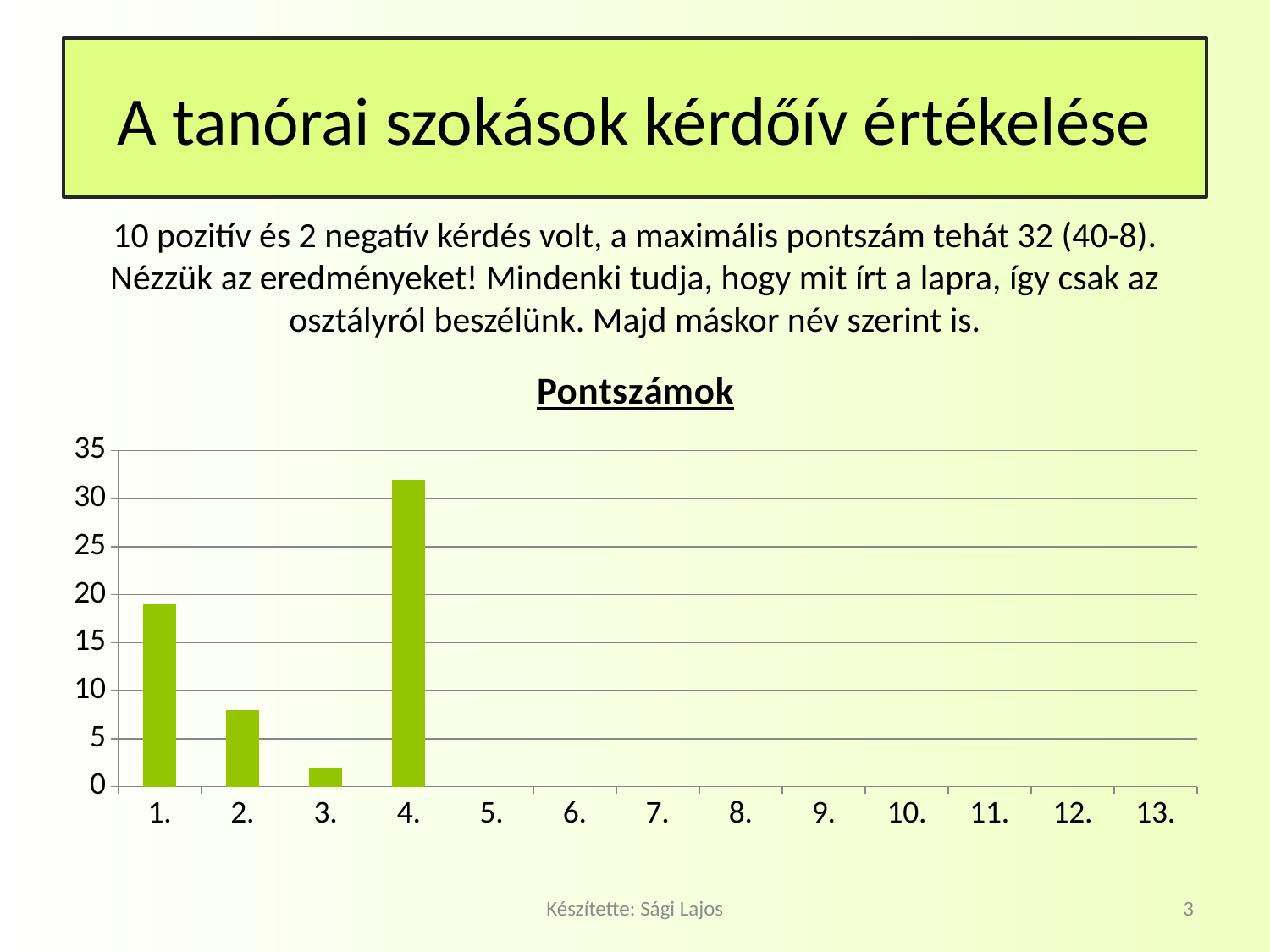
Is the value for category 1. greater or less than 20? less Which is larger, the value for category 1. or the value for category 2.? 1. Is the value for category 3. greater or less than 5? less Which category has the highest bar in the chart? 4. Among categories 1. to 4., which has the lowest bar? 3. How many categories are shown on the x axis of the chart? 13 What is the title of the chart? Pontszámok Which is larger, the value for category 3. or the value for category 4.? 4. Is the value for category 1. greater or less than 15? greater What kind of chart is shown on the slide? bar chart